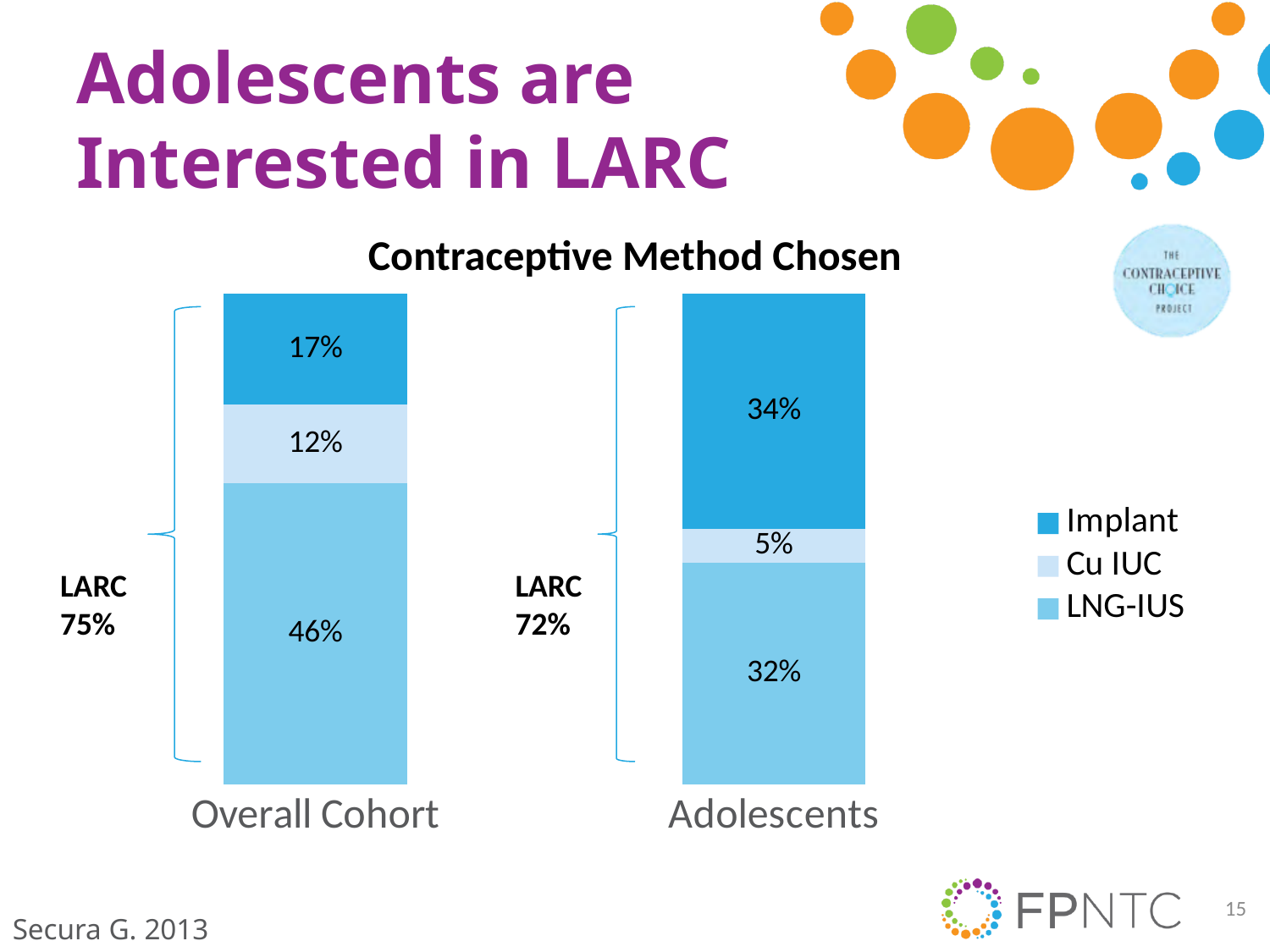
How many categories are shown on the x axis? 2 What is the difference between the Implant values for Adolescents and the Overall Cohort? 17% Which category has the higher Cu IUC value, Overall Cohort or Adolescents? Overall Cohort Which series has the lowest value in the Adolescents bar? Cu IUC What kind of chart is shown on the slide? Stacked bar chart Which series has the highest value in the Overall Cohort bar? LNG-IUS What is the Cu IUC value for Adolescents? 5% What is the total LARC share for the Adolescents bar? 72% How many series does the legend list? 3 What is the LNG-IUS value for the Overall Cohort? 46% What is the Implant value for the Overall Cohort? 17% What is the title of the chart? Contraceptive Method Chosen